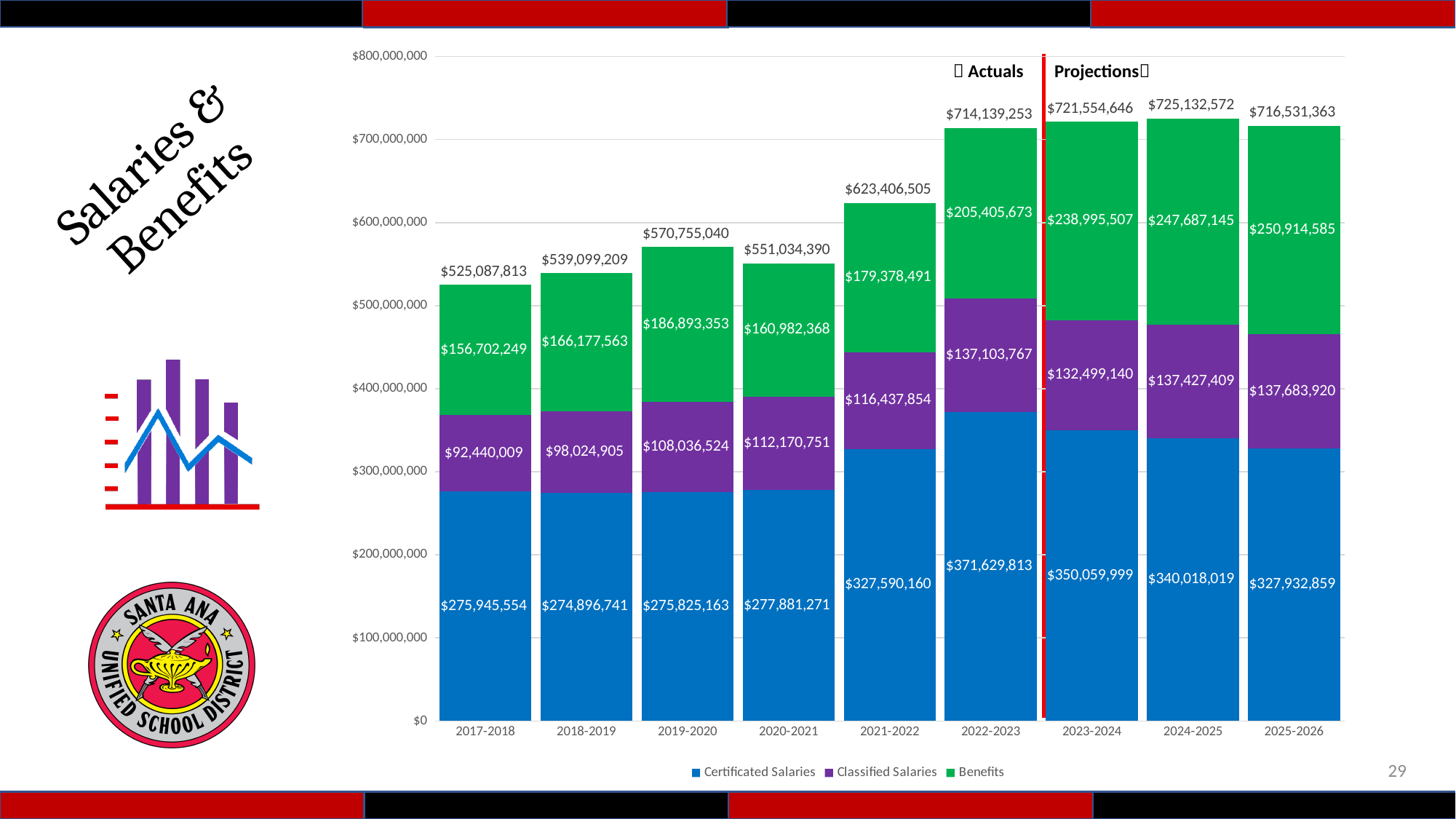
What is the value of Benefits for 2025-2026? $250,914,585 How many fiscal years are shown on the x axis? 9 Is the total for 2020-2021 greater or less than $600,000,000? less How many series does the legend list? 3 What kind of chart is shown on the slide? Stacked bar chart What is the value of Certificated Salaries for 2022-2023? $371,629,813 What is the value of Classified Salaries for 2019-2020? $108,036,524 Which year has the lowest total for salaries and benefits? 2017-2018 Which year has the highest total for salaries and benefits? 2024-2025 What is the total of the stacked bar for 2021-2022? $623,406,505 Which is larger: Certificated Salaries in 2023-2024 or in 2024-2025? 2023-2024 What is the difference between Benefits in 2023-2024 and Benefits in 2022-2023? $33,589,834